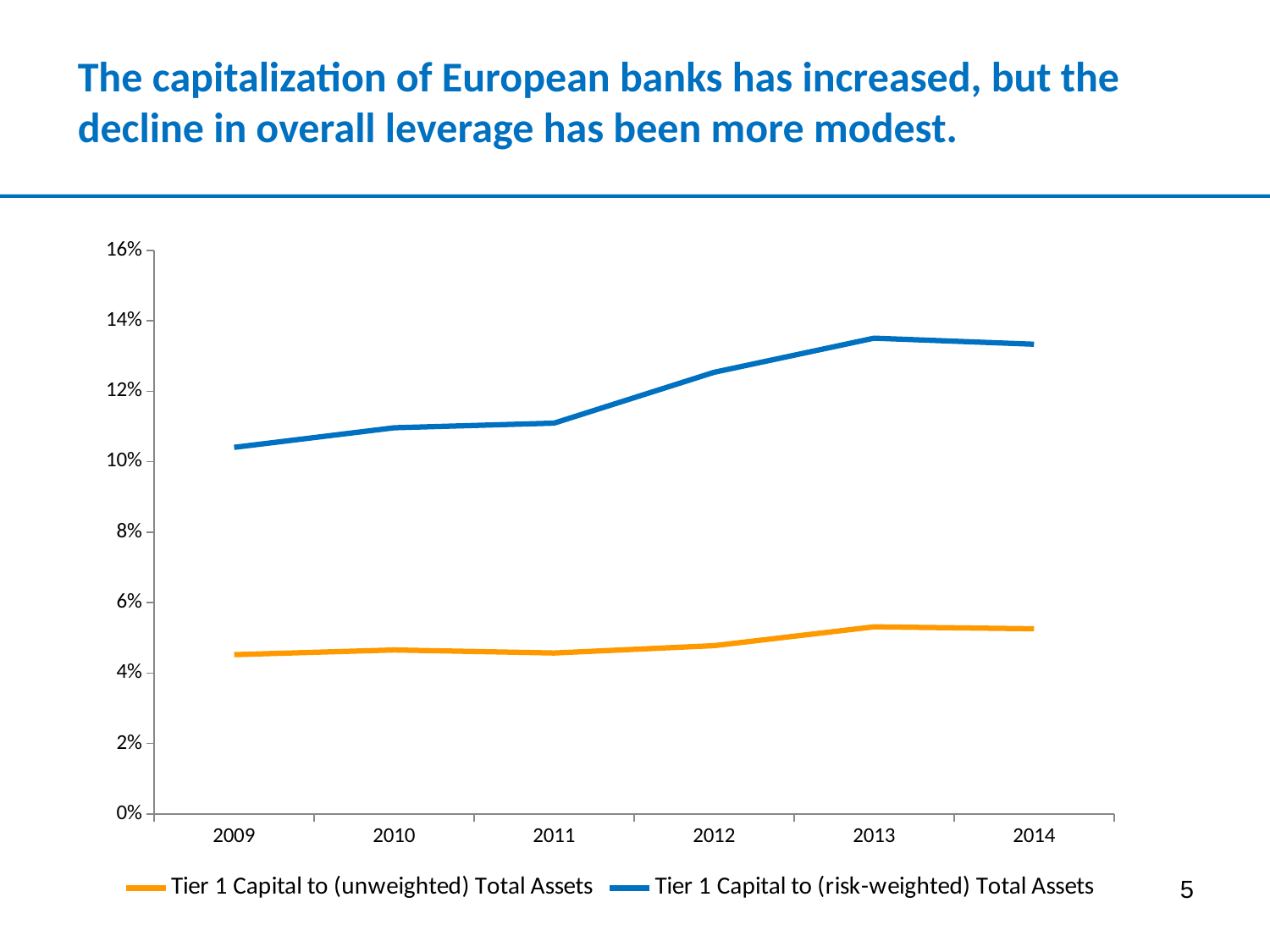
What kind of chart is shown on the slide? line chart Is the value for Tier 1 Capital to (risk-weighted) Total Assets in 2012 greater or less than 12%? greater Is the value for Tier 1 Capital to (unweighted) Total Assets in 2013 greater or less than 6%? less Is the value for Tier 1 Capital to (unweighted) Total Assets in 2009 greater or less than 4%? greater What colour is the line for Tier 1 Capital to (unweighted) Total Assets? orange How many years are plotted along the x axis? 6 Does Tier 1 Capital to (risk-weighted) Total Assets rise or fall from 2009 to 2013? rise Which series has the higher value in 2014, Tier 1 Capital to (unweighted) Total Assets or Tier 1 Capital to (risk-weighted) Total Assets? Tier 1 Capital to (risk-weighted) Total Assets In which year is Tier 1 Capital to (risk-weighted) Total Assets lowest? 2009 How many series does the legend list? 2